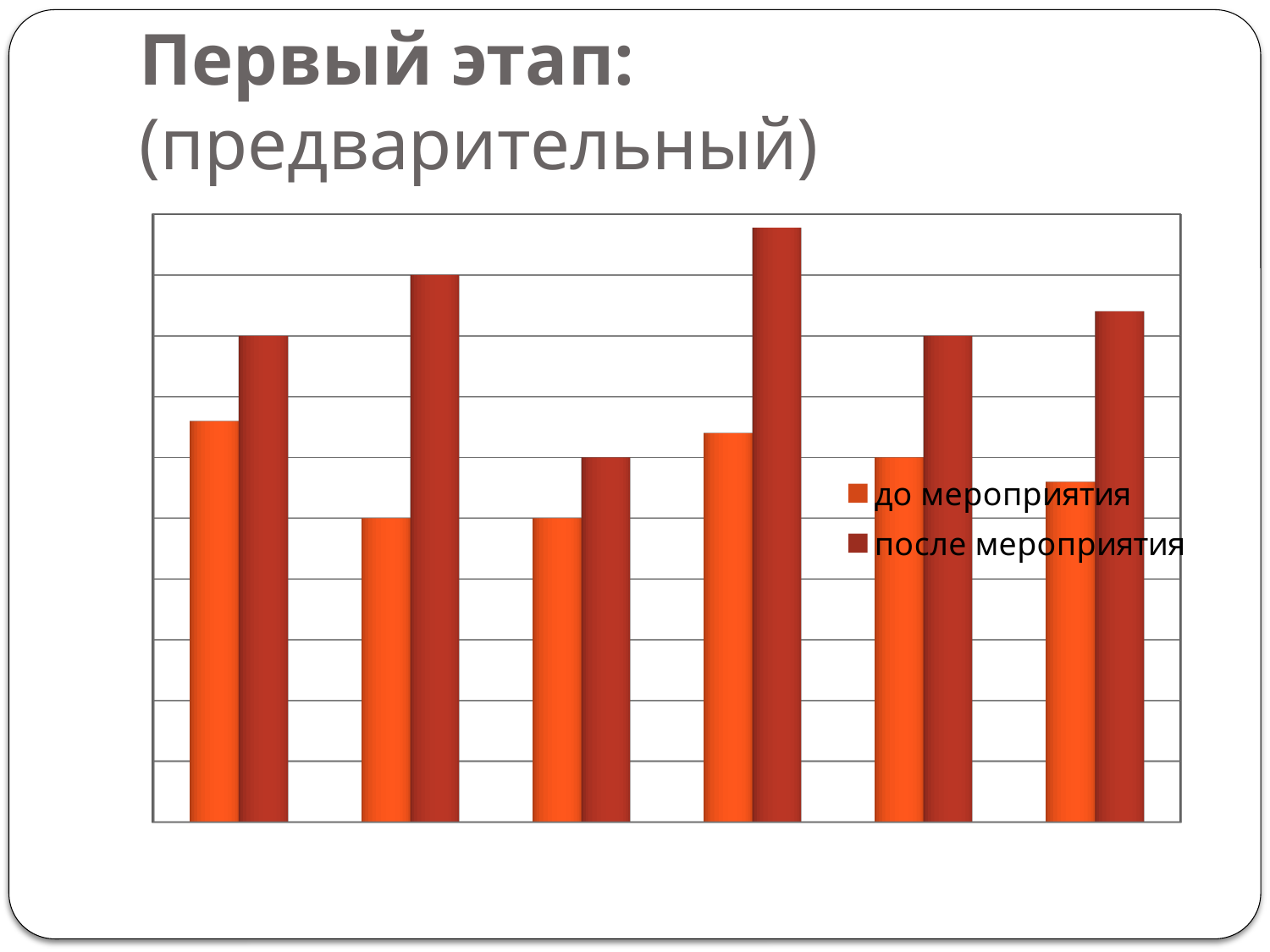
Which series is drawn in the darker red colour? после мероприятия Which is taller: the "после мероприятия" bar in the second group or the "после мероприятия" bar in the sixth group? the second group Which group of bars, counting from the left, has the tallest "до мероприятия" bar? the first group What are the two series named in the legend? до мероприятия, после мероприятия In the first group of bars from the left, which series has the larger value, "до мероприятия" or "после мероприятия"? после мероприятия Which group of bars, counting from the left, has the tallest "после мероприятия" bar? the fourth group How many groups of bars (categories) are plotted in the chart? 6 How many series does the legend list? 2 In the fourth group of bars from the left, which series has the larger value, "до мероприятия" or "после мероприятия"? после мероприятия What kind of chart is shown on the slide? bar chart Which group of bars, counting from the left, has the shortest "после мероприятия" bar? the third group